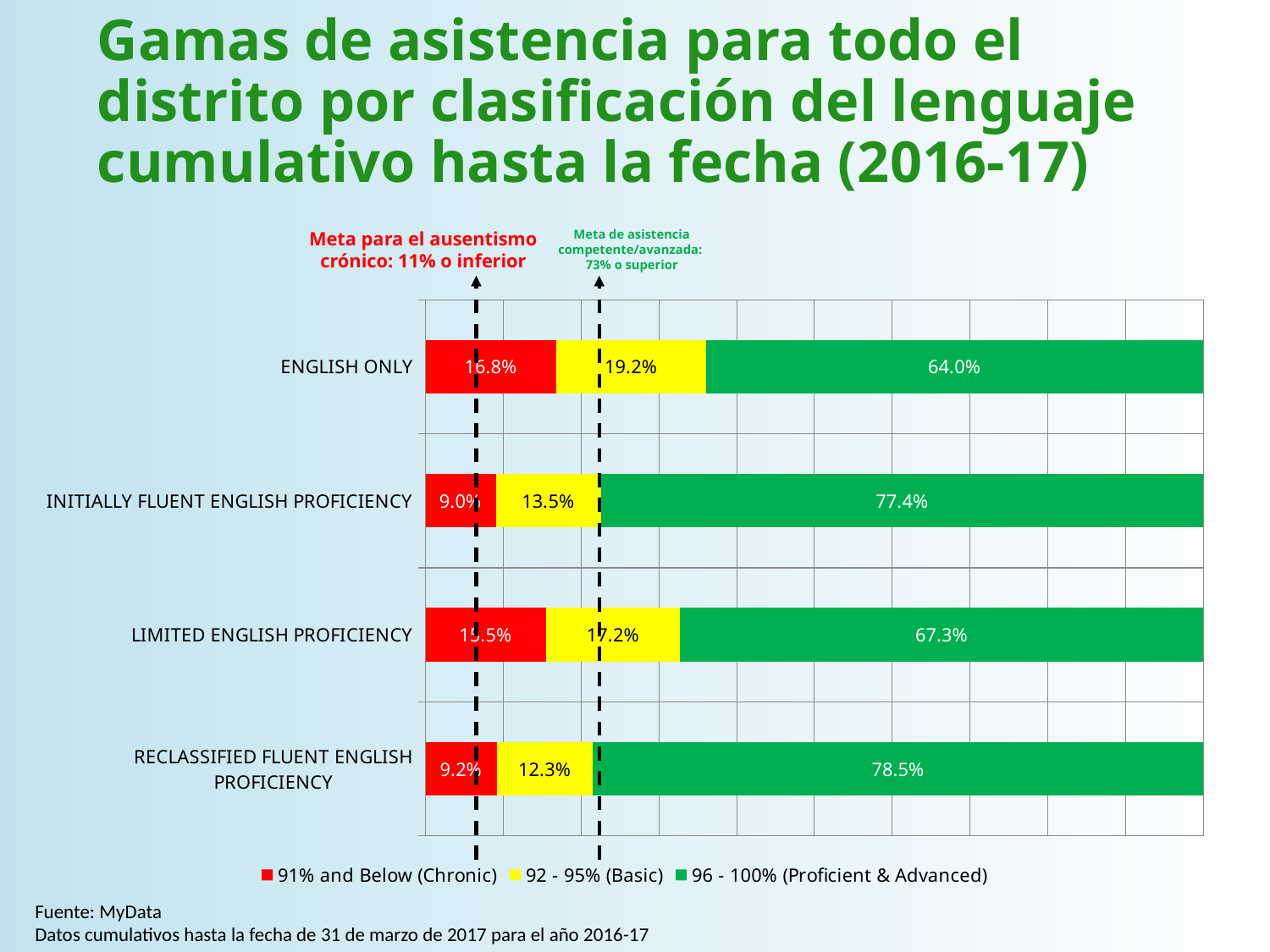
Which category has the lowest 96 - 100% (Proficient & Advanced) value? ENGLISH ONLY What is the value of the 92 - 95% (Basic) segment for INITIALLY FLUENT ENGLISH PROFICIENCY? 13.5% How many language classification categories are shown in the chart? 4 What is the value of the 96 - 100% (Proficient & Advanced) segment for LIMITED ENGLISH PROFICIENCY? 67.3% How many series does the legend list? 3 What is the value of the 91% and Below (Chronic) segment for RECLASSIFIED FLUENT ENGLISH PROFICIENCY? 9.2% Which has the larger 92 - 95% (Basic) value, ENGLISH ONLY or LIMITED ENGLISH PROFICIENCY? ENGLISH ONLY What kind of chart is shown on the slide? Stacked bar chart What is the difference between the 96 - 100% (Proficient & Advanced) values for RECLASSIFIED FLUENT ENGLISH PROFICIENCY and ENGLISH ONLY? 14.5 percentage points What is the value of the 96 - 100% (Proficient & Advanced) segment for ENGLISH ONLY? 64.0% Which category has the highest 91% and Below (Chronic) value? ENGLISH ONLY Which category has the highest 96 - 100% (Proficient & Advanced) value? RECLASSIFIED FLUENT ENGLISH PROFICIENCY